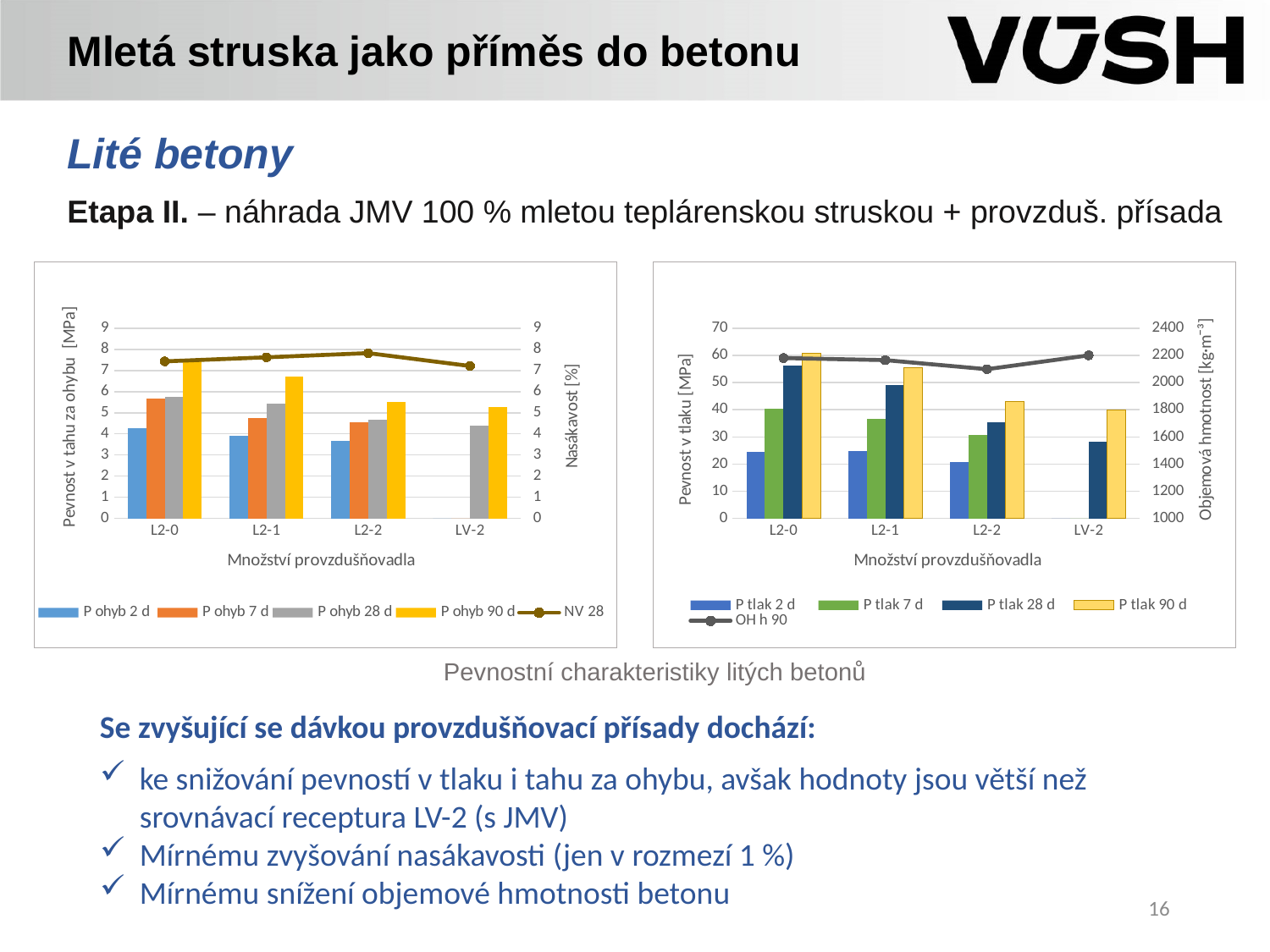
In the right chart (Pevnost v tlaku), which category has the lowest P tlak 28 d value? LV-2 In the left chart (Pevnost v tahu za ohybu), which is larger: the P ohyb 28 d value for L2-0 or for LV-2? L2-0 In the right chart (Pevnost v tlaku), how many series does the legend list? 5 In the right chart (Pevnost v tlaku), which category has the highest P tlak 90 d value? L2-0 What kind of chart is the right chart (Pevnost v tlaku)? bar chart with a line series In the left chart (Pevnost v tahu za ohybu), is the P ohyb 2 d value for L2-2 greater or less than 4? less In the right chart (Pevnost v tlaku), is the P tlak 2 d value for L2-2 greater or less than 30? less What is the x-axis title of the left chart? Množství provzdušňovadla In the right chart (Pevnost v tlaku), which is larger: the P tlak 90 d value for L2-0 or for LV-2? L2-0 In the left chart (Pevnost v tahu za ohybu), do the P ohyb 90 d values rise or fall from L2-0 to LV-2? fall In the left chart (Pevnost v tahu za ohybu), how many categories are shown on the x axis? 4 In the right chart (Pevnost v tlaku), is the P tlak 90 d value for L2-0 greater or less than 50? greater